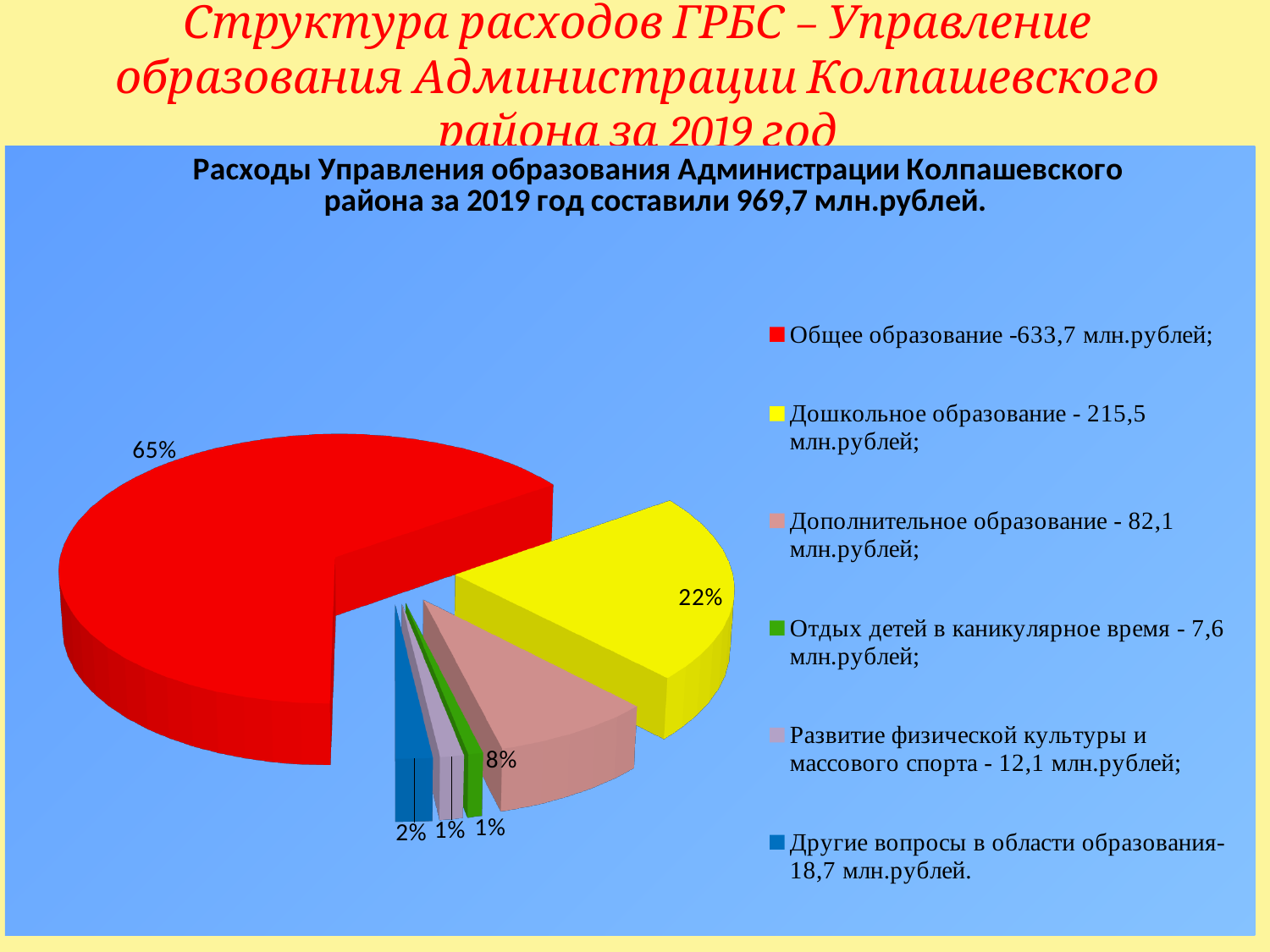
How many slices does the pie chart have? 6 According to the legend, how much was spent on Отдых детей в каникулярное время? 7,6 млн.рублей What colour is the slice for Общее образование? red Which category has the largest slice of the pie? Общее образование What share of the pie does Дошкольное образование take? 22% According to the legend, how much was spent on Дошкольное образование? 215,5 млн.рублей Which is larger, the slice for Дошкольное образование or the slice for Дополнительное образование? Дошкольное образование What share of the pie does Дополнительное образование take? 8% What share of the pie does Общее образование take? 65% How many entries does the legend list? 6 What kind of chart is shown on the slide? pie chart